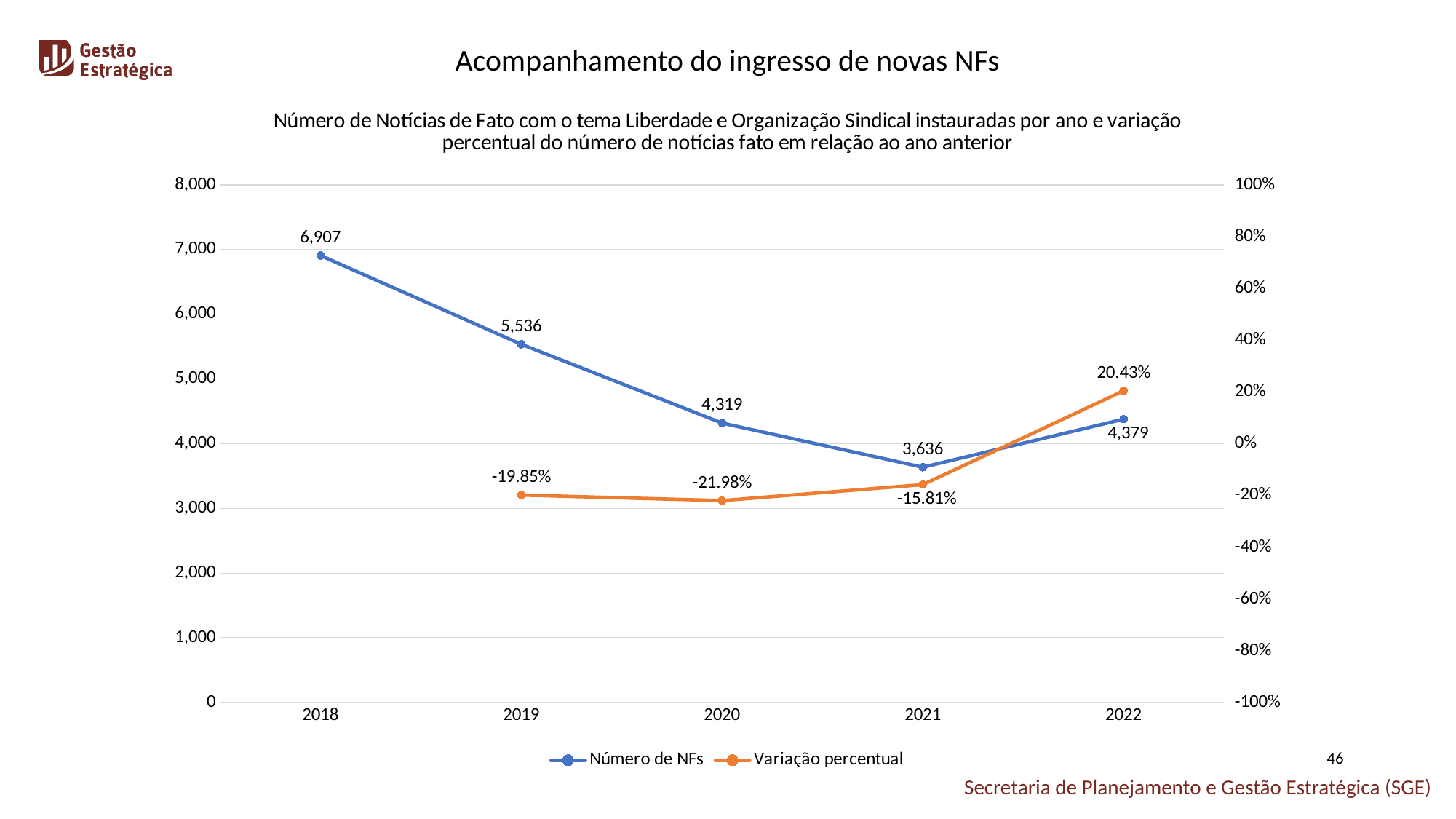
What is the difference between the Número de NFs in 2018 and 2019? 1,371 How many series does the legend list? 2 Does the Número de NFs rise or fall from 2018 to 2021? Fall Which year has the highest Número de NFs? 2018 What is the Variação percentual for 2022? 20.43% What kind of chart is shown on the slide? Line chart How many years are shown on the x axis? 5 What is the value of Número de NFs in 2018? 6,907 What is the value of Número de NFs in 2021? 3,636 What is the Variação percentual for 2020? -21.98% Which is larger, the Número de NFs in 2020 or in 2022? 2022 Which year has the lowest Número de NFs? 2021